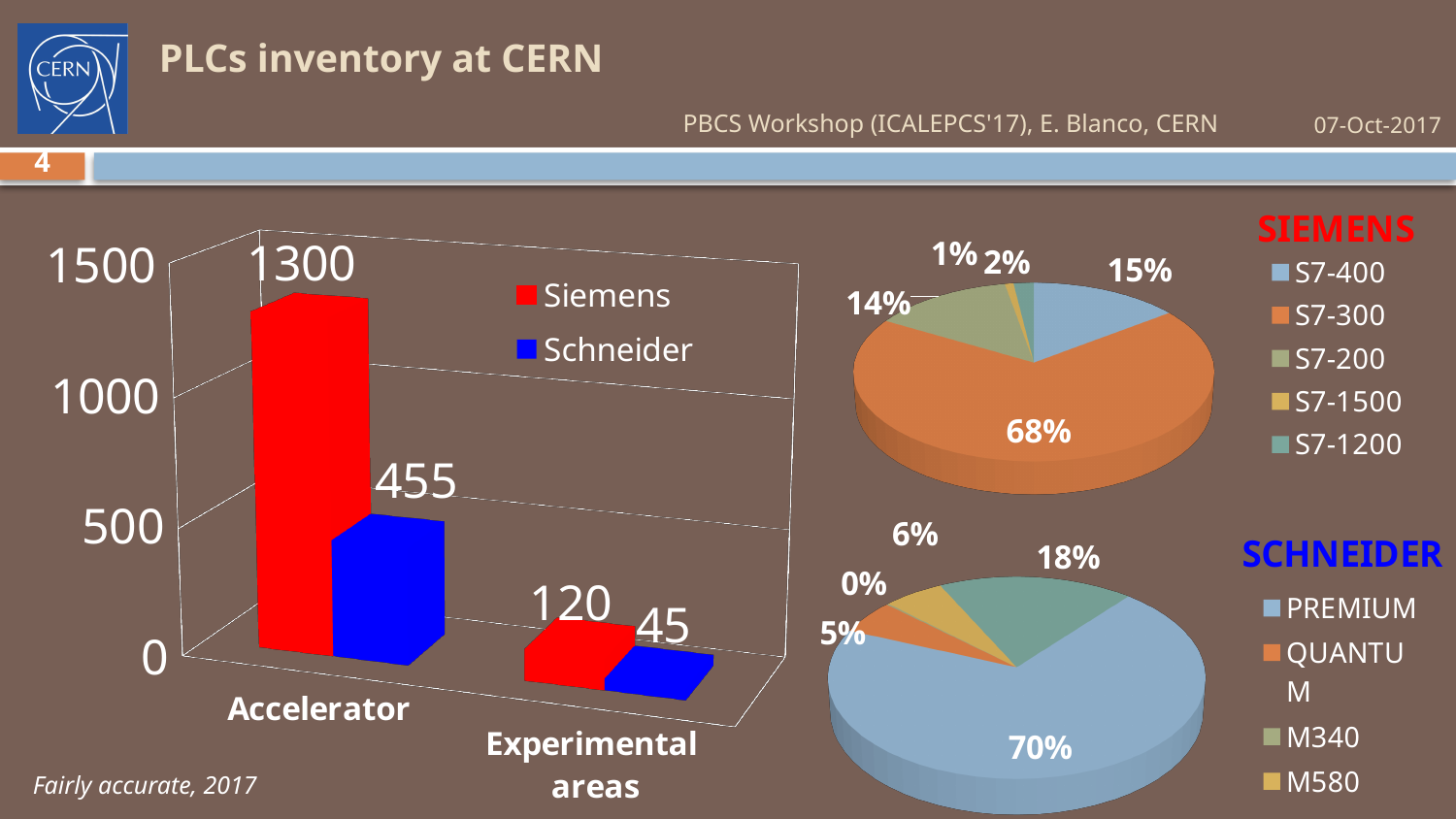
How many series does the legend of the bar chart list? 2 In the SIEMENS pie chart, what share does S7-300 have? 68% In the SIEMENS pie chart, what share does S7-400 have? 15% What kind of chart is the chart on the left of the slide? Bar chart In the bar chart, what is the value for Siemens in the Experimental areas category? 120 In the bar chart, what is the value for Siemens in the Accelerator category? 1300 In the bar chart, what is the difference between the Siemens and Schneider values in the Accelerator category? 845 In the bar chart, which series has the larger value in the Experimental areas category, Siemens or Schneider? Siemens In the SCHNEIDER pie chart, what share does PREMIUM have? 70% In the bar chart, what is the value for Schneider in the Experimental areas category? 45 In the bar chart, what is the value for Schneider in the Accelerator category? 455